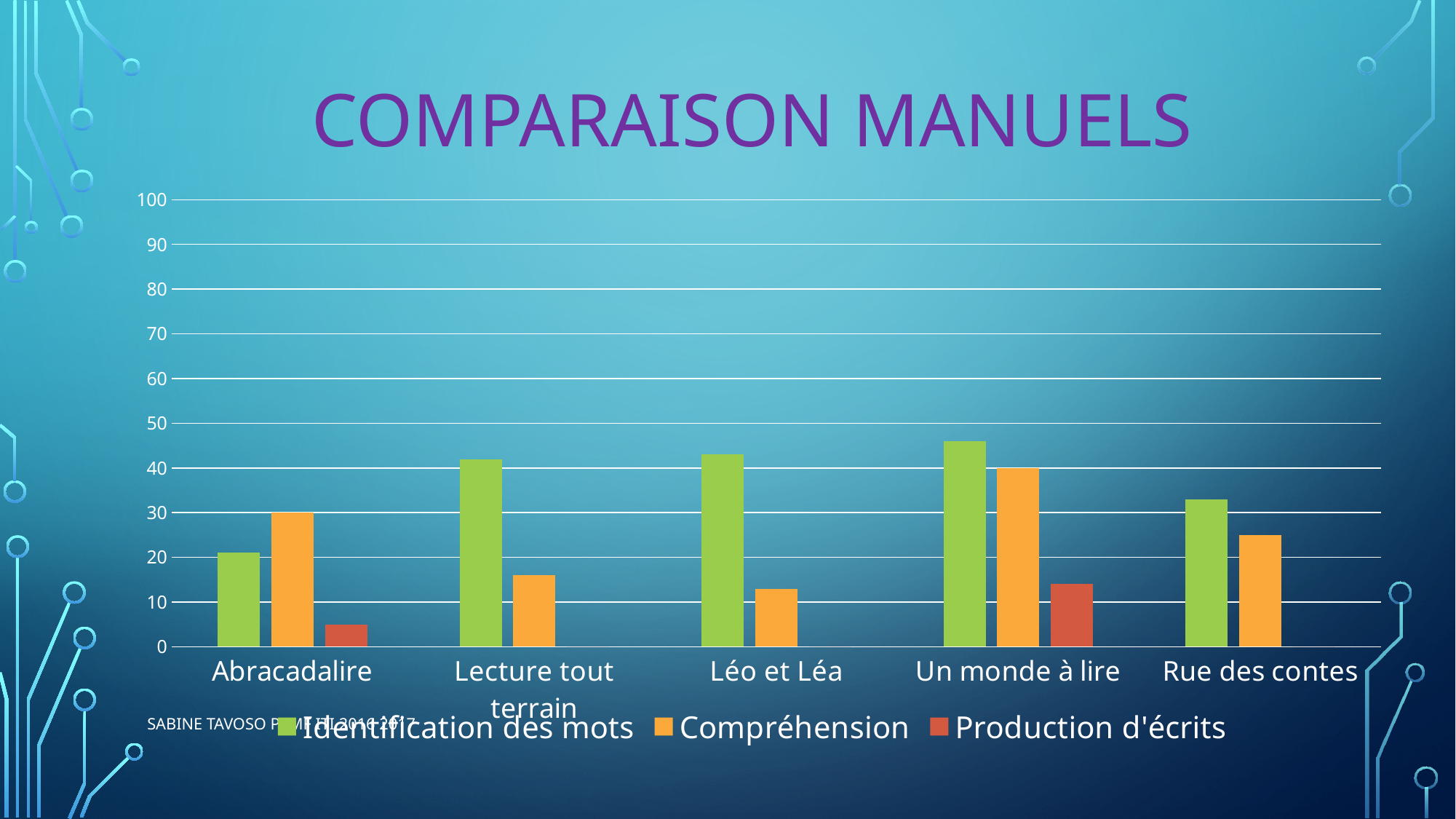
What is the title of the chart? COMPARAISON MANUELS Is the Production d'écrits value for Abracadalire greater or less than 10? less Which manual has the lowest value for Identification des mots? Abracadalire What kind of chart is shown on the slide? bar chart How many manuals (categories) are shown on the x axis? 5 What is the Compréhension value for Abracadalire? 30 What is the Compréhension value for Un monde à lire? 40 How many series does the legend list? 3 Which manual has the highest value for Identification des mots? Un monde à lire Which manual has the highest value for Compréhension? Un monde à lire For Abracadalire, which is larger: Identification des mots or Compréhension? Compréhension Is the Identification des mots value for Léo et Léa greater or less than 40? greater